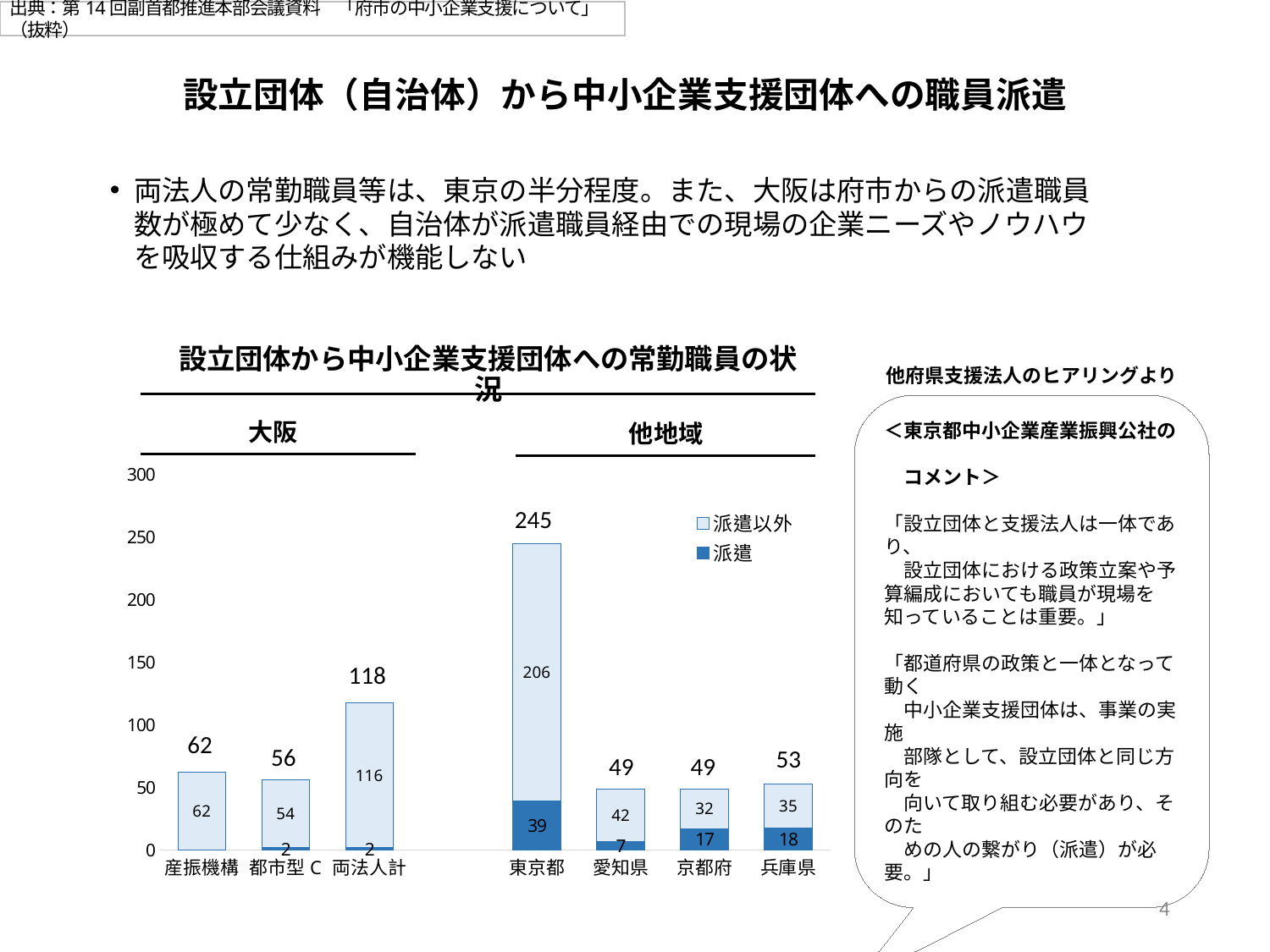
Which category has the highest total? 東京都 How many categories are shown on the x axis? 7 Which is larger, the 派遣 value for 京都府 or the 派遣 value for 愛知県? 京都府 What kind of chart is shown? stacked bar chart What is the 派遣以外 value for 両法人計? 116 What is the difference between the totals for 東京都 and 両法人計? 127 What is the total value shown above the bar for 東京都? 245 Is the total for 両法人計 greater or less than 100? greater What are the two group headings above the chart? 大阪 and 他地域 What is the 派遣 value for 東京都? 39 How many series does the legend list? 2 What is the 派遣 value for 兵庫県? 18